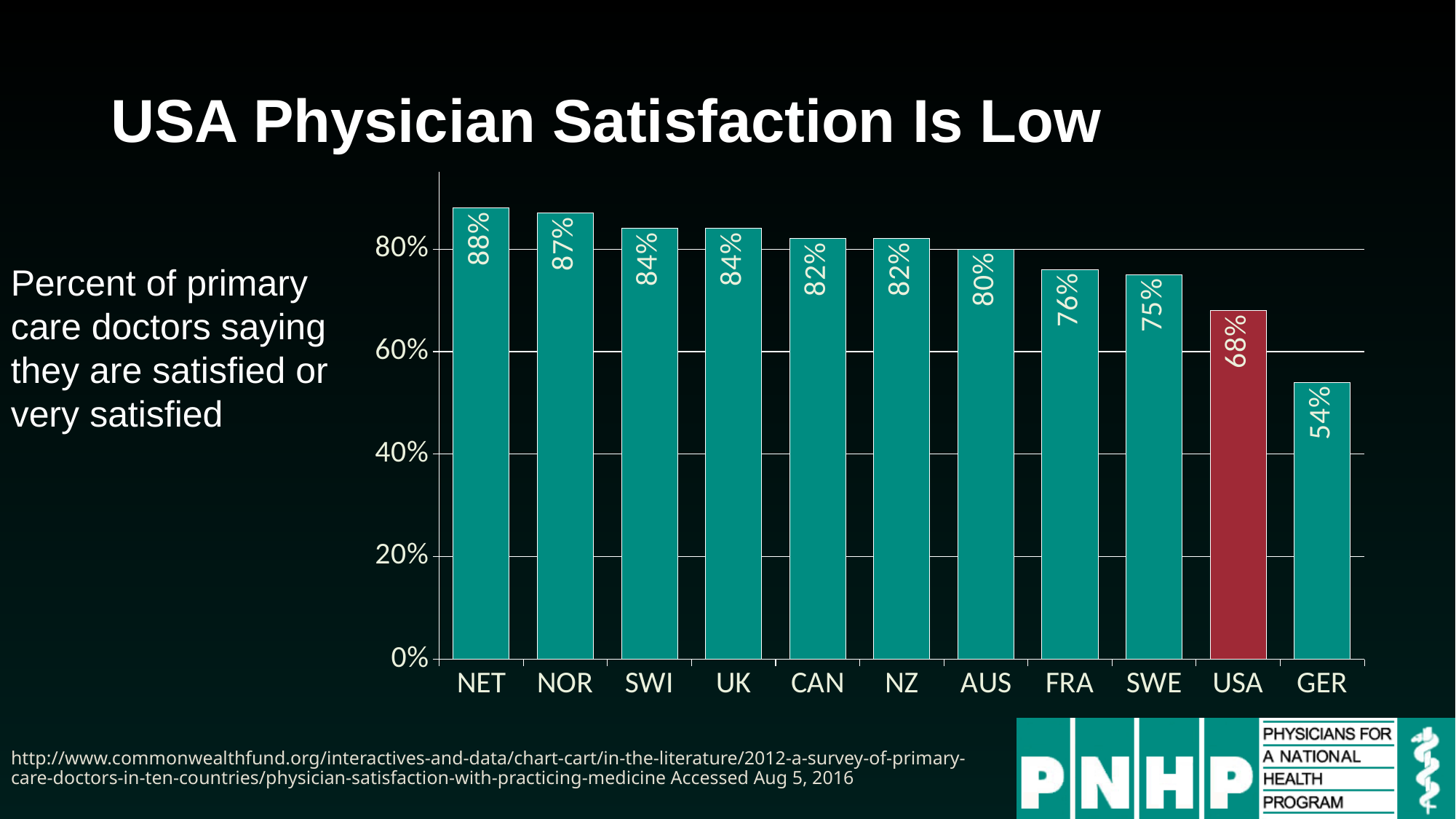
What is the value for USA? 68% Is the value for USA greater or less than 60%? greater How many countries are shown on the chart? 11 What is the difference between the values for USA and GER? 14% Which country has the lowest value? GER What is the value for GER? 54% What kind of chart is shown on the slide? bar chart Which is larger, the value for FRA or the value for SWE? FRA What is the difference between the values for NET and USA? 20% What is the value for NET? 88% Which bar is coloured differently from the others? USA Which country has the highest value? NET